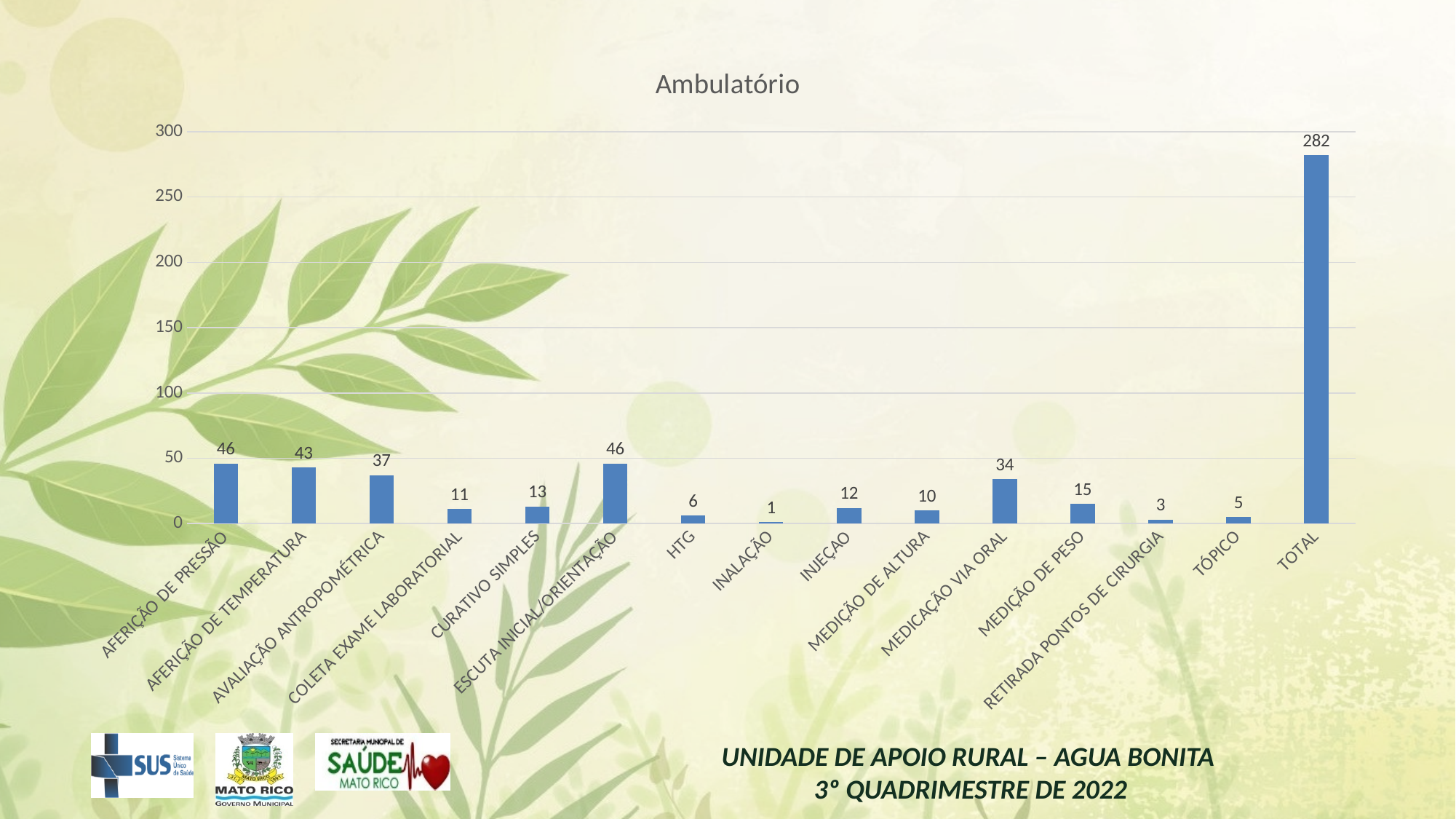
How many categories are shown on the x axis? 15 What is the value for RETIRADA PONTOS DE CIRURGIA? 3 What is the value for AFERIÇÃO DE TEMPERATURA? 43 Which category has the highest value? TOTAL What kind of chart is shown? bar chart What is the difference between AFERIÇÃO DE PRESSÃO and AVALIAÇÃO ANTROPOMÉTRICA? 9 What is the value for MEDICAÇÃO VIA ORAL? 34 What is the value for the TOTAL bar? 282 Is the value for TOTAL greater or less than 250? greater Which is larger, CURATIVO SIMPLES or MEDIÇÃO DE PESO? MEDIÇÃO DE PESO What is the title of the chart? Ambulatório Which category has the lowest value? INALAÇÃO